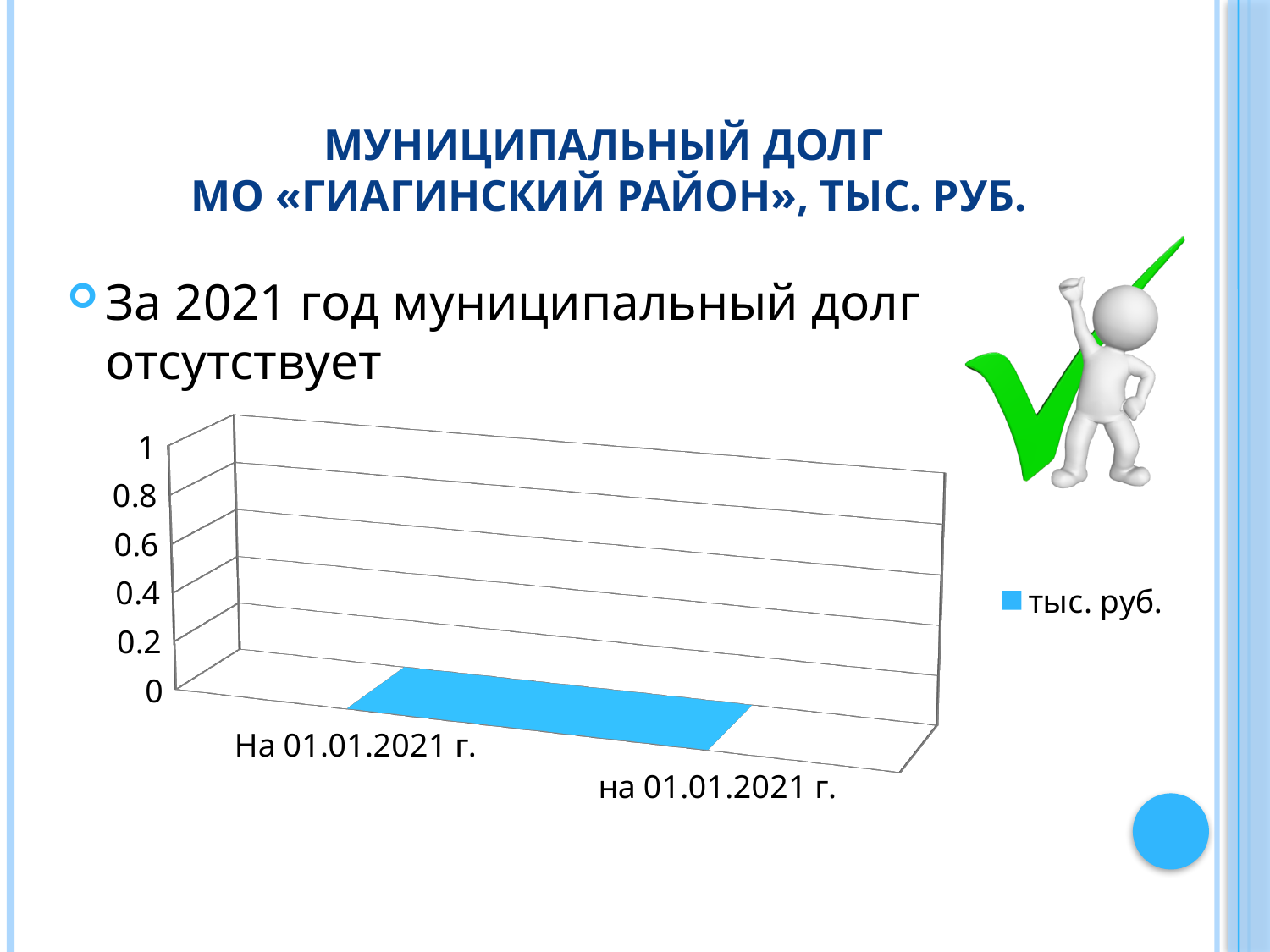
What is the difference between the values for "На 01.01.2021 г." and "на 01.01.2021 г."? 0 How many series does the chart legend list? 1 What is the highest value shown on the chart's vertical axis? 1 What is the value for "на 01.01.2021 г." (the second category) in the chart? 0 How many categories are shown on the x axis of the chart? 2 What is the value for "На 01.01.2021 г." in the chart? 0 What kind of chart is shown on the slide? line chart Is the value for "На 01.01.2021 г." greater or less than 0.2? less Is the value for the second category "на 01.01.2021 г." greater or less than 0.4? less What is the legend entry of the chart? тыс. руб. Do the values rise, fall, or stay the same from the first category to the second? stay the same